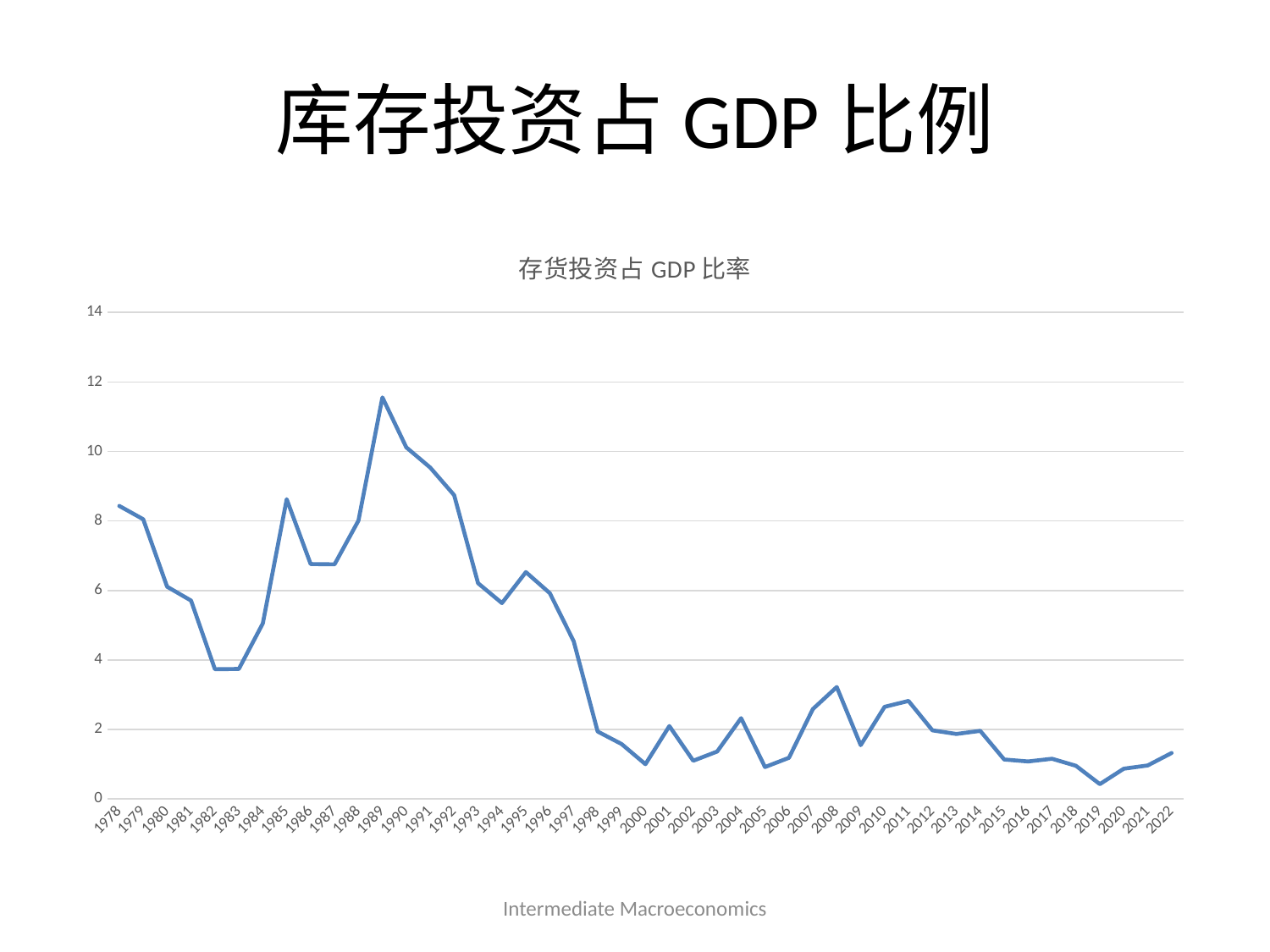
What kind of chart is shown on the slide? line chart In which year does the line reach its lowest value? 2019 Is the value for 2019 greater or less than 2? less In which year does the line reach its highest value? 1989 Which year has the larger value, 1985 or 1983? 1985 What is the title of the chart? 存货投资占 GDP 比率 Which year has the larger value, 2005 or 2008? 2008 Overall, does the line rise or fall from 1978 to 2022? fall Is the value for 1989 greater or less than 10? greater Is the value for 1982 greater or less than 4? less How many years are plotted on the x axis of the chart? 45